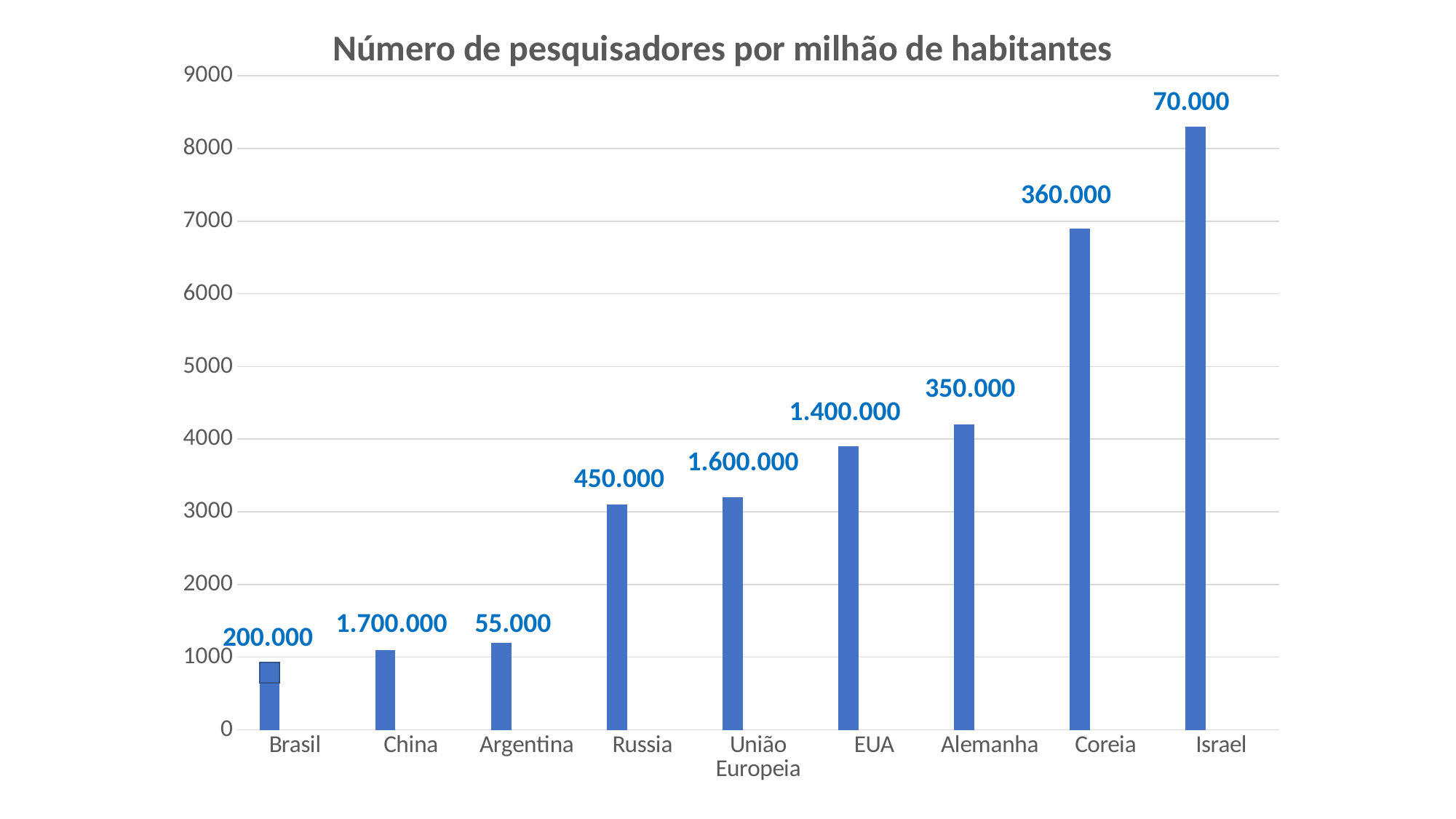
Which category has the highest bar in the chart? Israel Is the bar for Coreia greater or less than 7000? less How many countries or regions are shown on the x axis of the chart? 9 What is the title of the chart? Número de pesquisadores por milhão de habitantes Which has a taller bar, Coreia or Alemanha? Coreia Is the bar for Israel greater or less than 8000? greater What kind of chart is shown on the slide? bar chart Is the bar for Brasil greater or less than 1000? less Which category has the lowest bar in the chart? Brasil Do the bar heights generally rise or fall from left to right along the x axis? rise What number is printed above the bar for Israel? 70.000